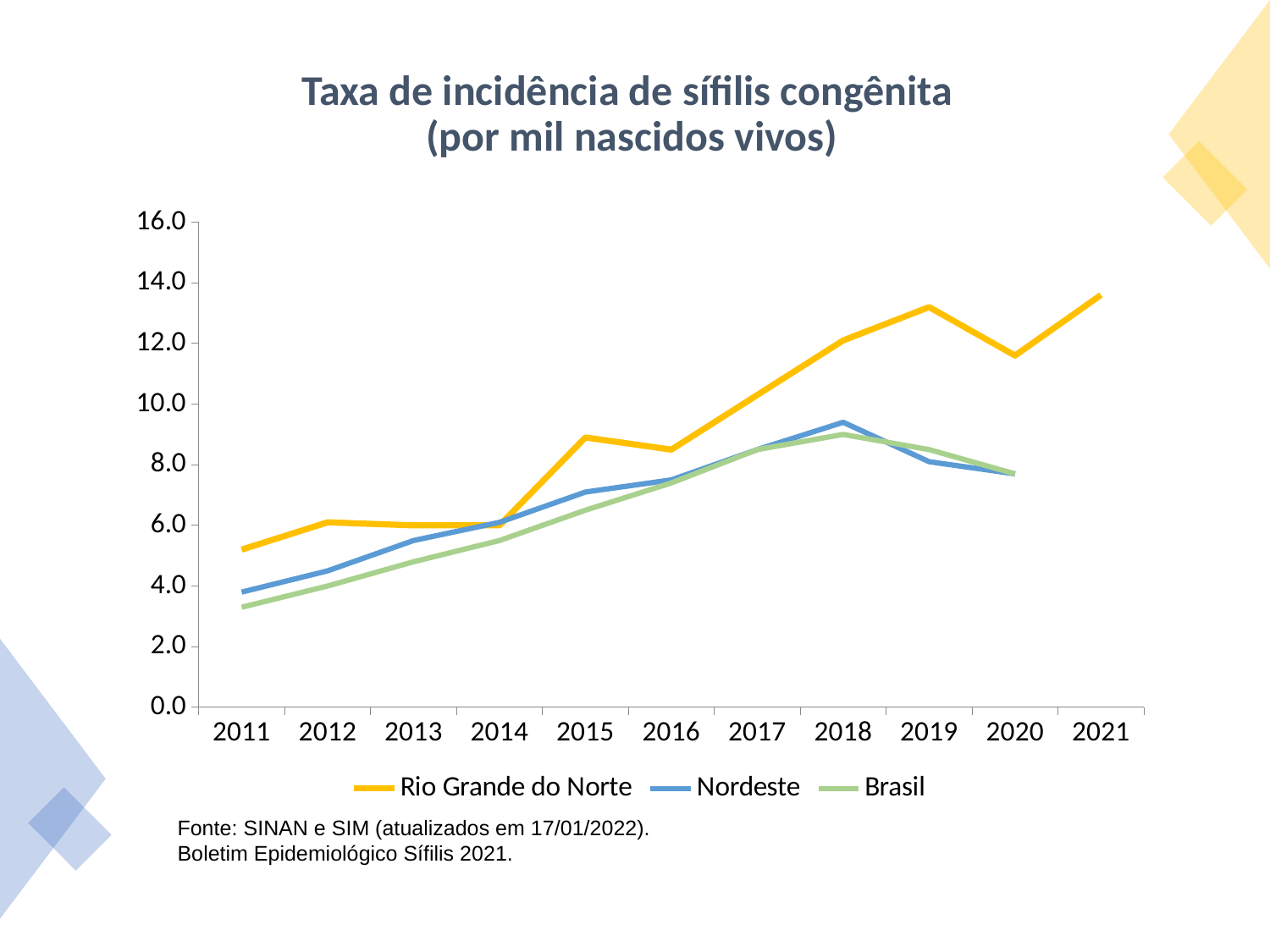
In 2018, which is larger: the value for Rio Grande do Norte or the value for Nordeste? Rio Grande do Norte In which year does the Rio Grande do Norte line have its lowest value? 2011 Is the value for Rio Grande do Norte in 2019 greater or less than 12.0? greater How many series does the legend list? 3 Does the Brasil line rise or fall from 2011 to 2018? rise Is the value for Rio Grande do Norte in 2020 greater or less than 10.0? greater How many years are shown on the x axis? 11 In which year does the Nordeste line reach its peak? 2018 What kind of chart is shown on the slide? Line chart Is the value for Brasil in 2011 greater or less than 4.0? less In which year does the Rio Grande do Norte line reach its highest value? 2021 What is the title of the chart? Taxa de incidência de sífilis congênita (por mil nascidos vivos)